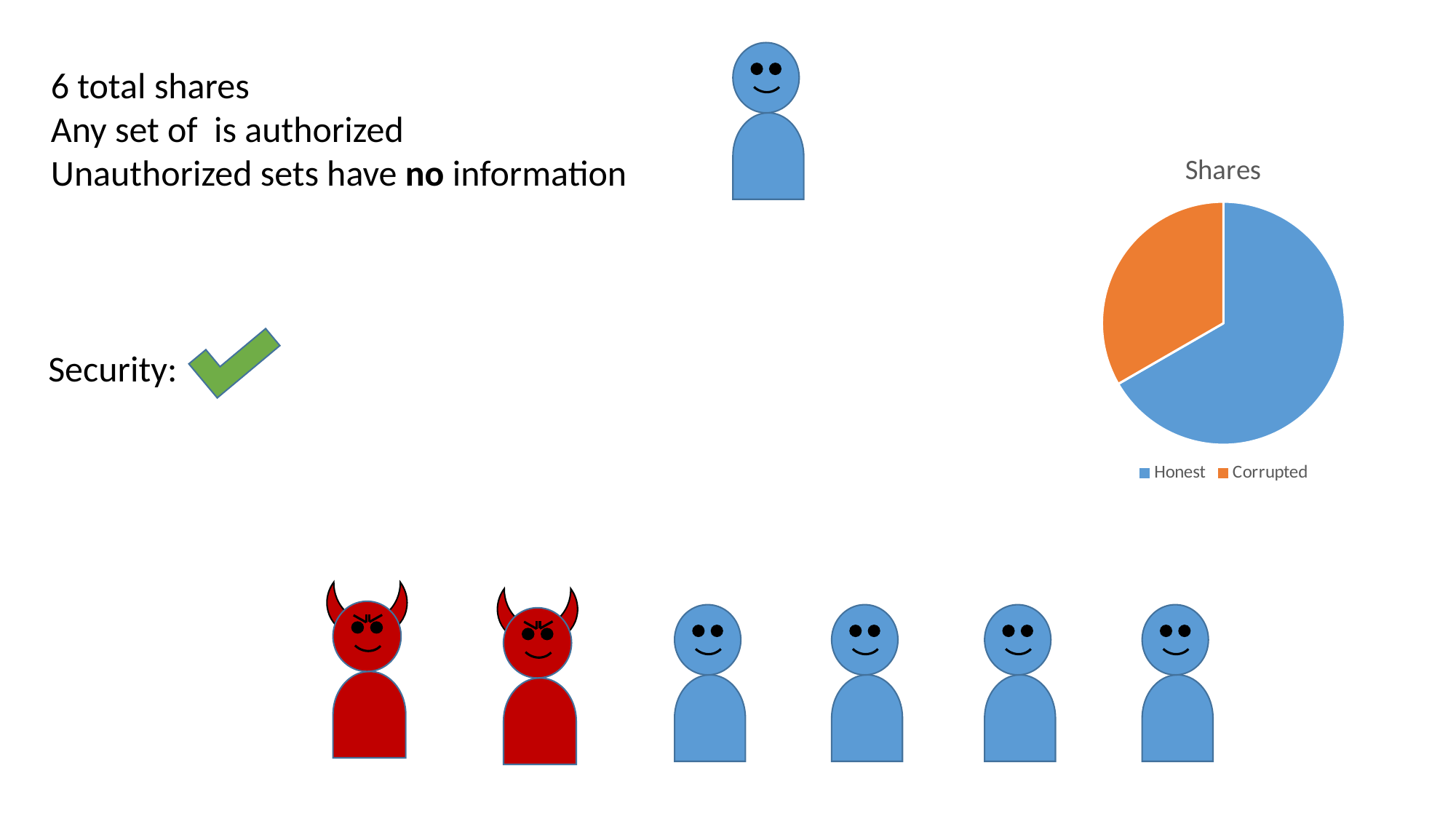
What is the title of the pie chart? Shares What colour is the Corrupted slice in the pie chart? orange How many slices does the pie chart have? 2 Which slice of the pie chart is the smallest? Corrupted Does the Honest slice take up more or less than half of the pie chart? more How many entries does the legend of the pie chart list? 2 In the pie chart, which slice is larger, Honest or Corrupted? Honest Which slice of the pie chart is the largest? Honest What kind of chart is shown on the slide? pie chart